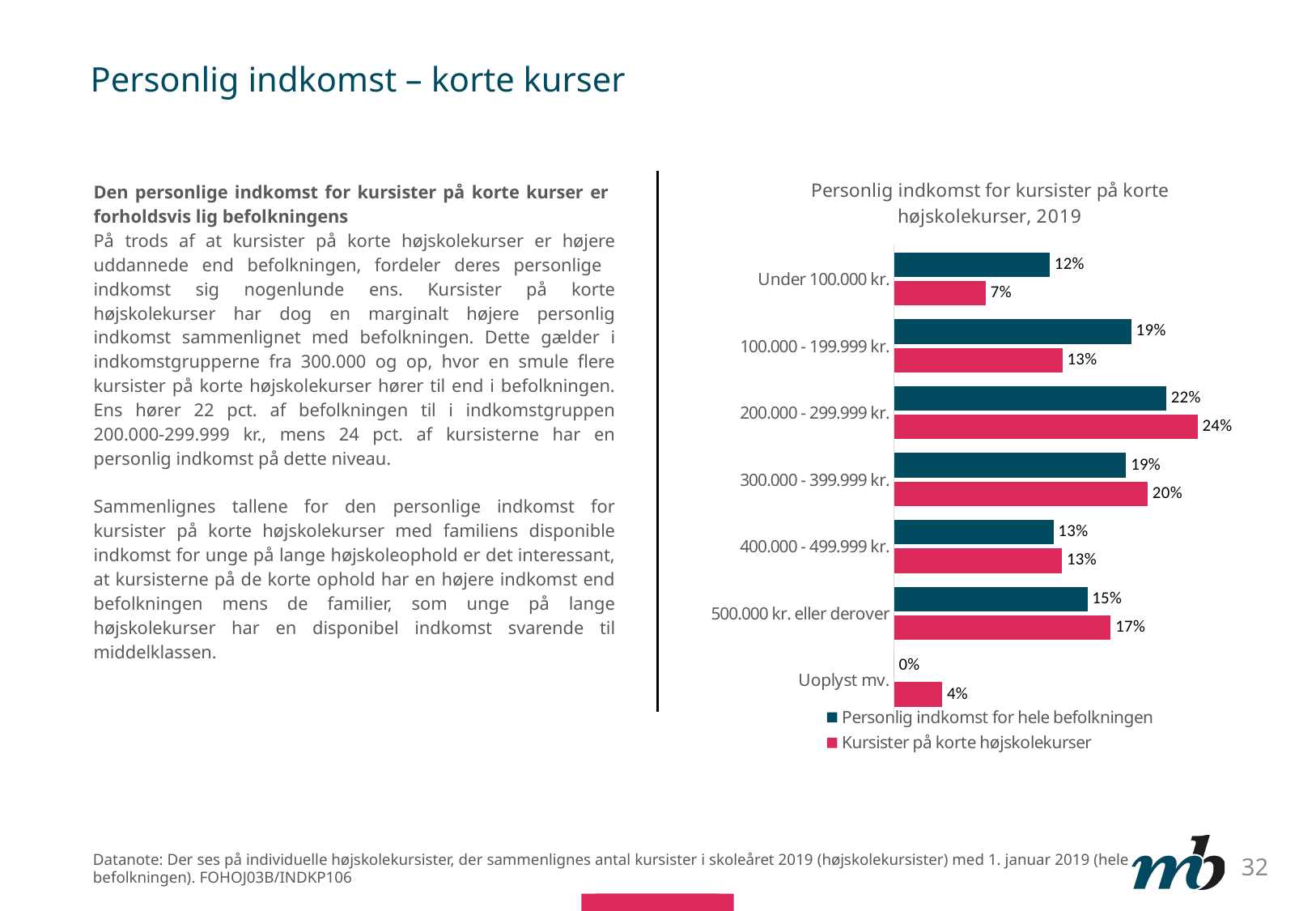
What is the value for 'Personlig indkomst for hele befolkningen' in the '100.000 - 199.999 kr.' category? 19% What is the value for 'Kursister på korte højskolekurser' in the '200.000 - 299.999 kr.' category? 24% Which income category has the lowest value for 'Personlig indkomst for hele befolkningen'? Uoplyst mv. What kind of chart is shown on the slide? Bar chart Which income category has the highest value for 'Kursister på korte højskolekurser'? 200.000 - 299.999 kr. What is the value for 'Kursister på korte højskolekurser' in the 'Uoplyst mv.' category? 4% What is the title of the chart? Personlig indkomst for kursister på korte højskolekurser, 2019 How many income categories are shown on the chart? 7 What is the difference between the two series in the 'Under 100.000 kr.' category? 5 percentage points In the '500.000 kr. eller derover' category, which series has the larger value? Kursister på korte højskolekurser How many series does the legend list? 2 What is the value for 'Personlig indkomst for hele befolkningen' in the 'Under 100.000 kr.' category? 12%